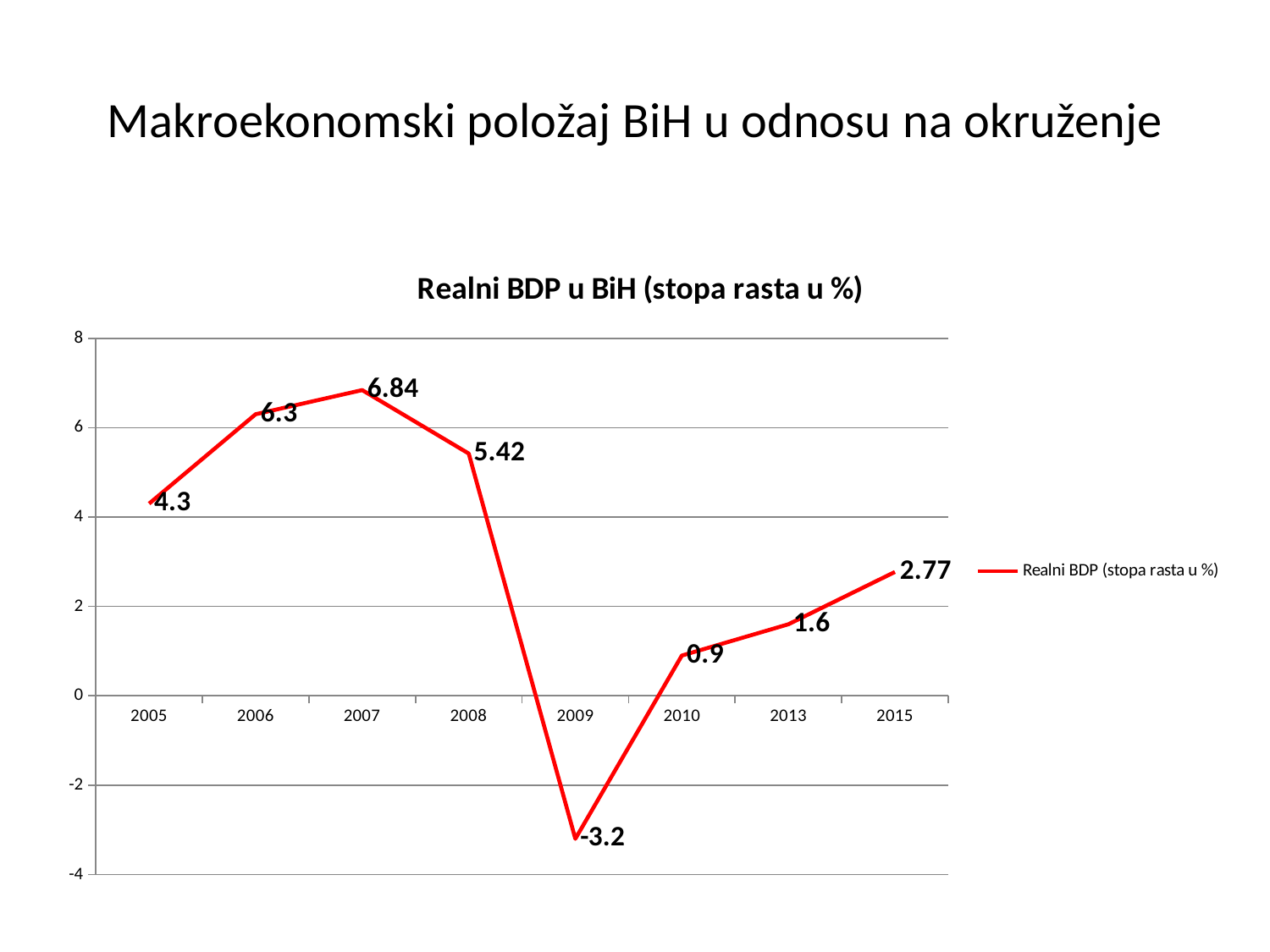
Is the value for 2005 greater or less than 4? greater What kind of chart is shown on the slide? line chart What is the difference between the values for 2007 and 2008? 1.42 What is the title of the chart? Realni BDP u BiH (stopa rasta u %) What is the real GDP growth rate shown for 2007? 6.84 Which year has the lowest value on the chart? 2009 Which year has the highest value on the chart? 2007 What value is plotted for 2009? -3.2 How many years are plotted on the x axis? 8 What is the value for 2015? 2.77 Which is larger, the value for 2006 or the value for 2010? 2006 How many series does the legend list? 1